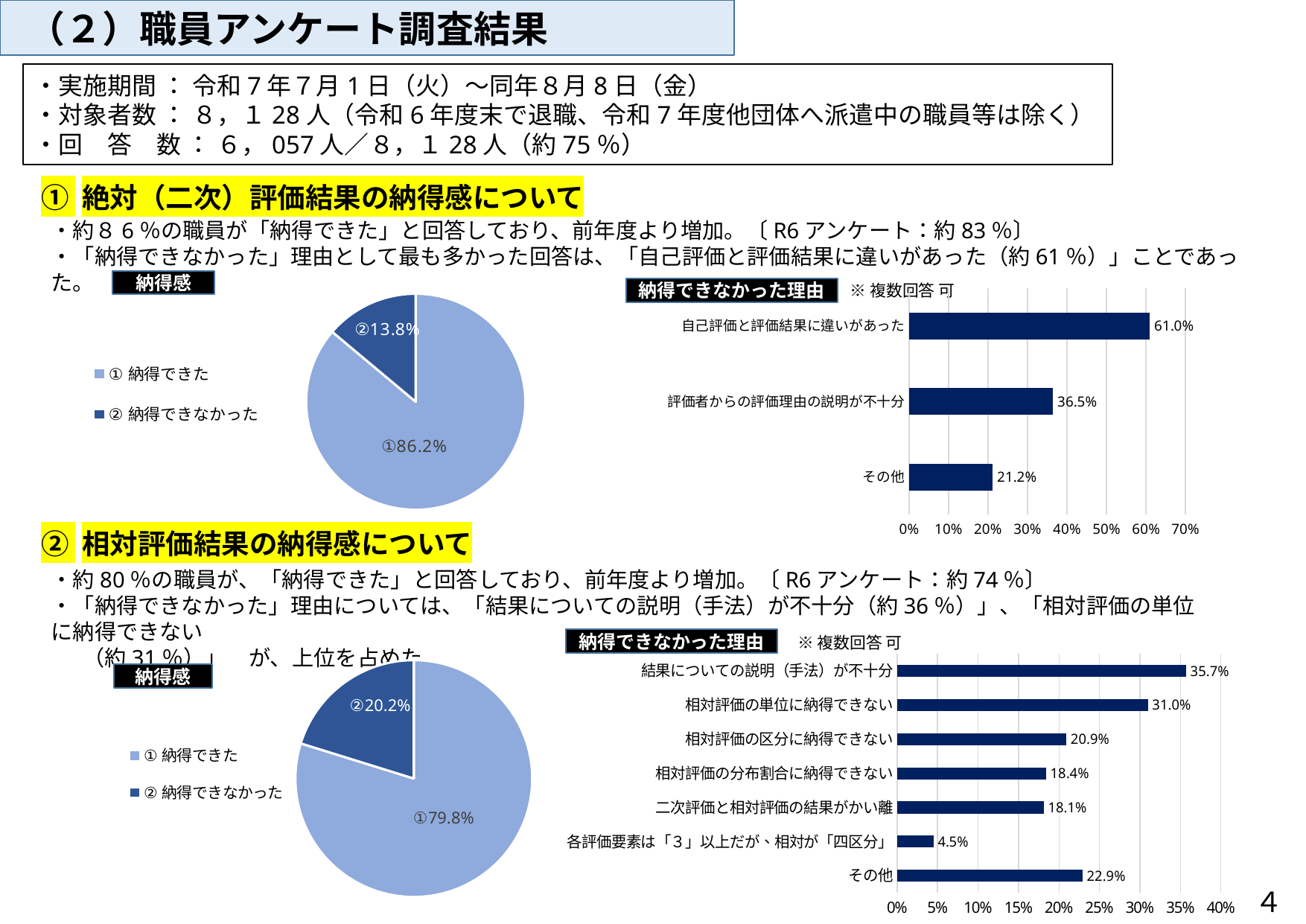
In the bottom-right bar chart (納得できなかった理由 under ②), which category has the highest value? 結果についての説明（手法）が不十分 In the top-right bar chart (納得できなかった理由 under ①), how many categories are plotted? 3 In the bottom-right bar chart (納得できなかった理由 under ②), how many categories are plotted? 7 In the top-left pie chart (納得感 under ①), what share is shown for ① 納得できた? 86.2% In the top-right bar chart (納得できなかった理由 under ①), what is the difference between 自己評価と評価結果に違いがあった and 評価者からの評価理由の説明が不十分? 24.5% In the bottom-right bar chart (納得できなかった理由 under ②), what is the value for 各評価要素は「3」以上だが、相対が「四区分」? 4.5% In the bottom-left pie chart (納得感 under ②), what share is shown for ② 納得できなかった? 20.2% In the bottom-left pie chart (納得感 under ②), what share is shown for ① 納得できた? 79.8% In the top-right bar chart (納得できなかった理由 under ①), which category has the lowest value? その他 In the bottom-right bar chart (納得できなかった理由 under ②), which is larger: その他 or 相対評価の区分に納得できない? その他 In the top-right bar chart (納得できなかった理由 under ①), what is the value for 自己評価と評価結果に違いがあった? 61.0% In the top-left pie chart (納得感 under ①), what share is shown for ② 納得できなかった? 13.8%